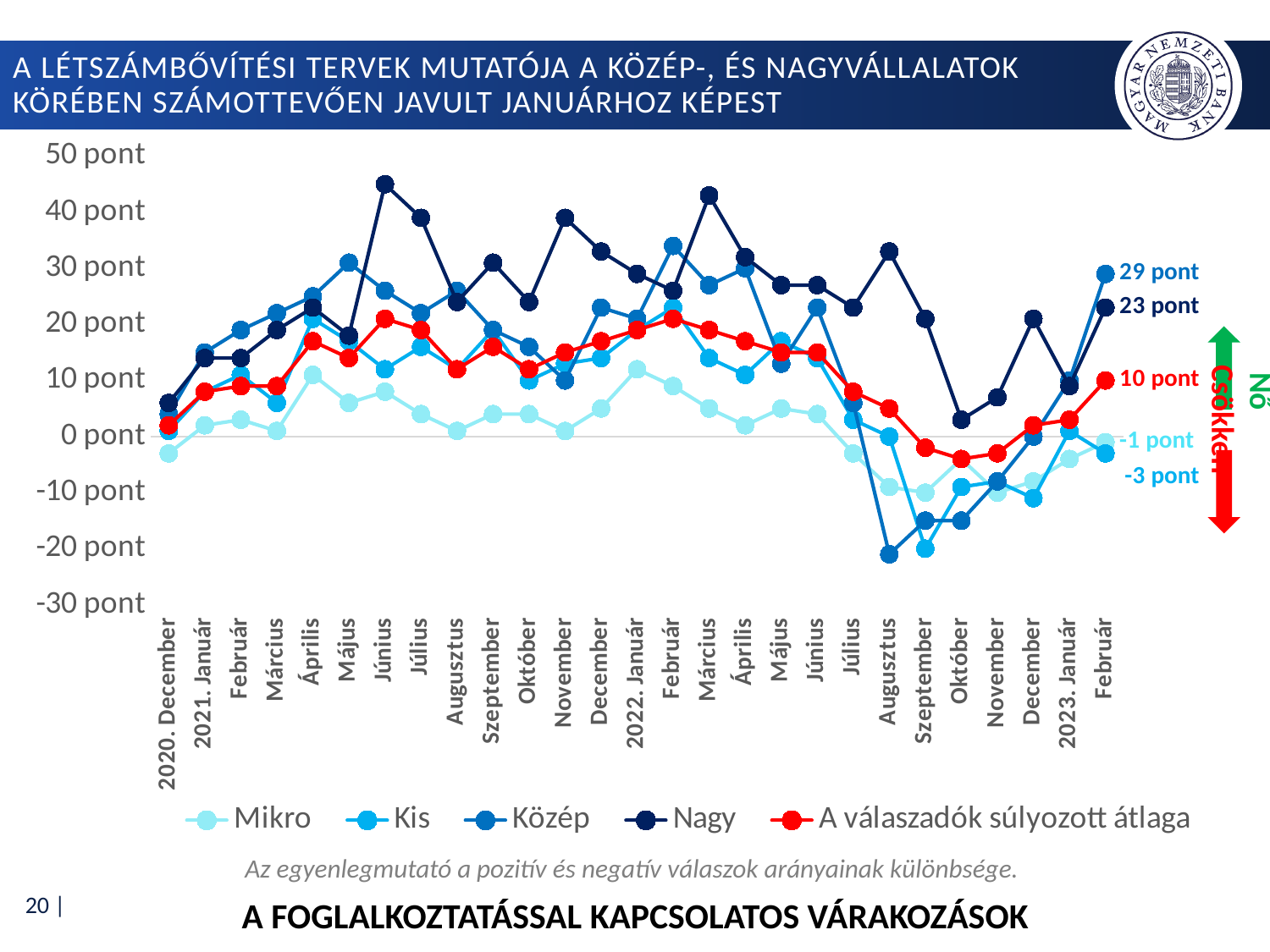
What is the value of the Nagy series in 2023. Február? 23 pont What is the value of the Közép series in 2023. Február? 29 pont What is the value of the Kis series in 2023. Február? -3 pont What is the value of 'A válaszadók súlyozott átlaga' in 2023. Február? 10 pont How many series does the legend list? 5 What is the value of the Mikro series in 2023. Február? -1 pont Which series has the lowest value in 2023. Február? Kis Is the value for the Nagy series in 2021 Június greater or less than 40 pont? greater In 2023. Február, how much higher is the Közép series than the Nagy series? 6 pont Which series has the highest value in 2023. Február? Közép What kind of chart is shown on the slide? Line chart Is the value for the Kis series in 2022 Augusztus greater or less than -10 pont? greater